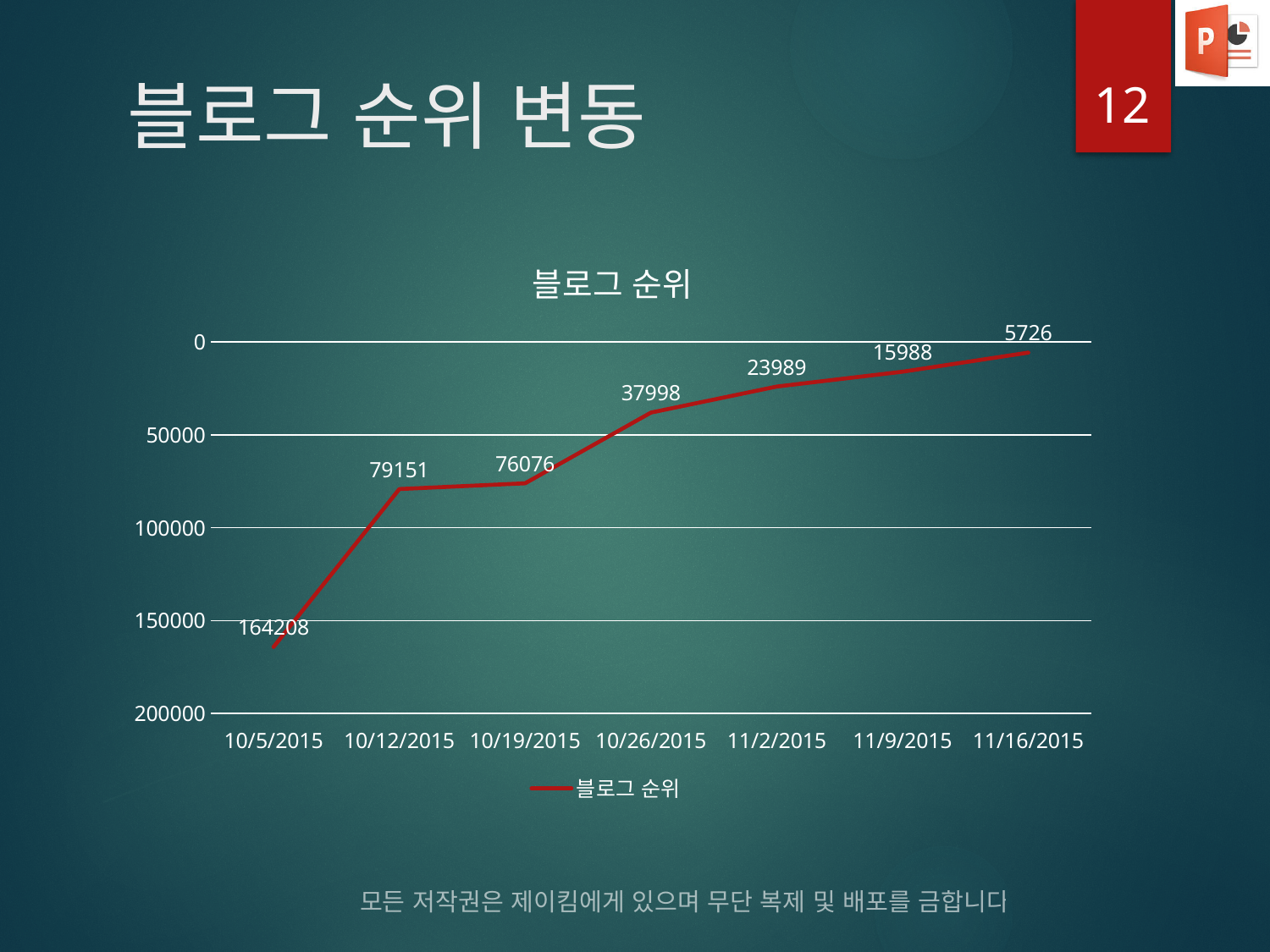
What is the blog rank value for 10/5/2015? 164208 Which date has the lowest blog rank value? 11/16/2015 What is the blog rank value for 10/26/2015? 37998 How many dates are plotted on the x axis? 7 Do the plotted values rise or fall from 10/5/2015 to 11/16/2015? fall What is the blog rank value for 11/16/2015? 5726 Which date has the highest blog rank value? 10/5/2015 Which is larger, the value for 10/12/2015 or the value for 10/19/2015? 10/12/2015 What type of chart is shown on the slide? line chart What is the difference between the values for 11/9/2015 and 11/16/2015? 10262 What is the difference between the values for 10/5/2015 and 10/12/2015? 85057 What is the blog rank value for 11/2/2015? 23989